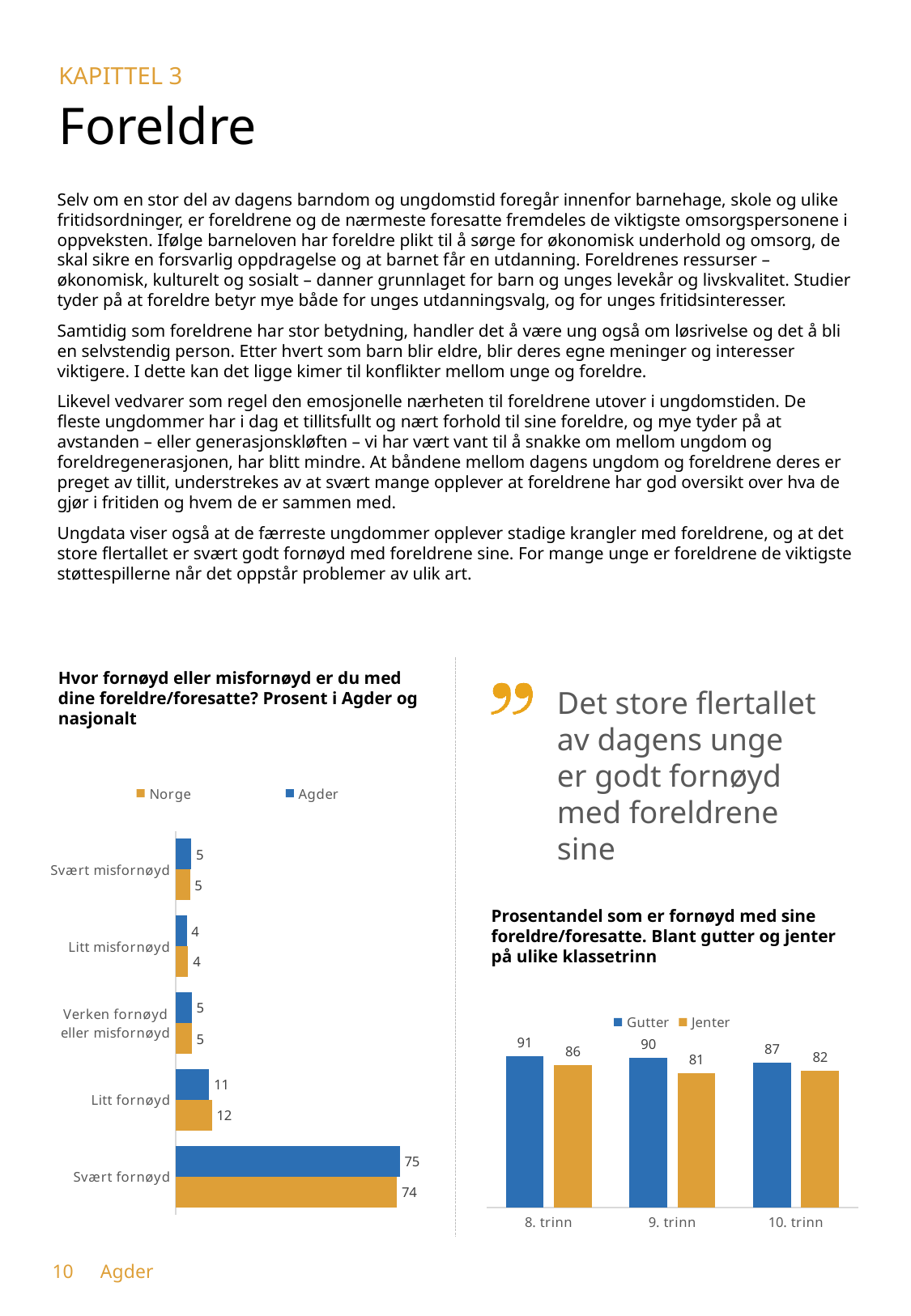
In the left chart (Hvor fornøyd eller misfornøyd er du med dine foreldre/foresatte?), what is the Norge value for Litt fornøyd? 12 What type of chart is the left chart (Hvor fornøyd eller misfornøyd er du med dine foreldre/foresatte?)? Bar chart In the left chart (Hvor fornøyd eller misfornøyd er du med dine foreldre/foresatte?), which category has the highest Agder value? Svært fornøyd In the left chart (Hvor fornøyd eller misfornøyd er du med dine foreldre/foresatte?), how many series does the legend list? 2 In the right chart (Prosentandel som er fornøyd med sine foreldre/foresatte), which grade has the lowest Jenter value? 9. trinn In the right chart (Prosentandel som er fornøyd med sine foreldre/foresatte), does the Gutter value rise or fall from 8. trinn to 10. trinn? Fall In the right chart (Prosentandel som er fornøyd med sine foreldre/foresatte), what is the Jenter value for 9. trinn? 81 In the left chart (Hvor fornøyd eller misfornøyd er du med dine foreldre/foresatte?), what is the difference between the Agder and Norge values for Svært fornøyd? 1 In the left chart (Hvor fornøyd eller misfornøyd er du med dine foreldre/foresatte?), what is the Agder value for Svært fornøyd? 75 In the right chart (Prosentandel som er fornøyd med sine foreldre/foresatte), what is the difference between Gutter and Jenter for 10. trinn? 5 In the left chart (Hvor fornøyd eller misfornøyd er du med dine foreldre/foresatte?), how many categories are shown? 5 In the right chart (Prosentandel som er fornøyd med sine foreldre/foresatte), what is the Gutter value for 8. trinn? 91